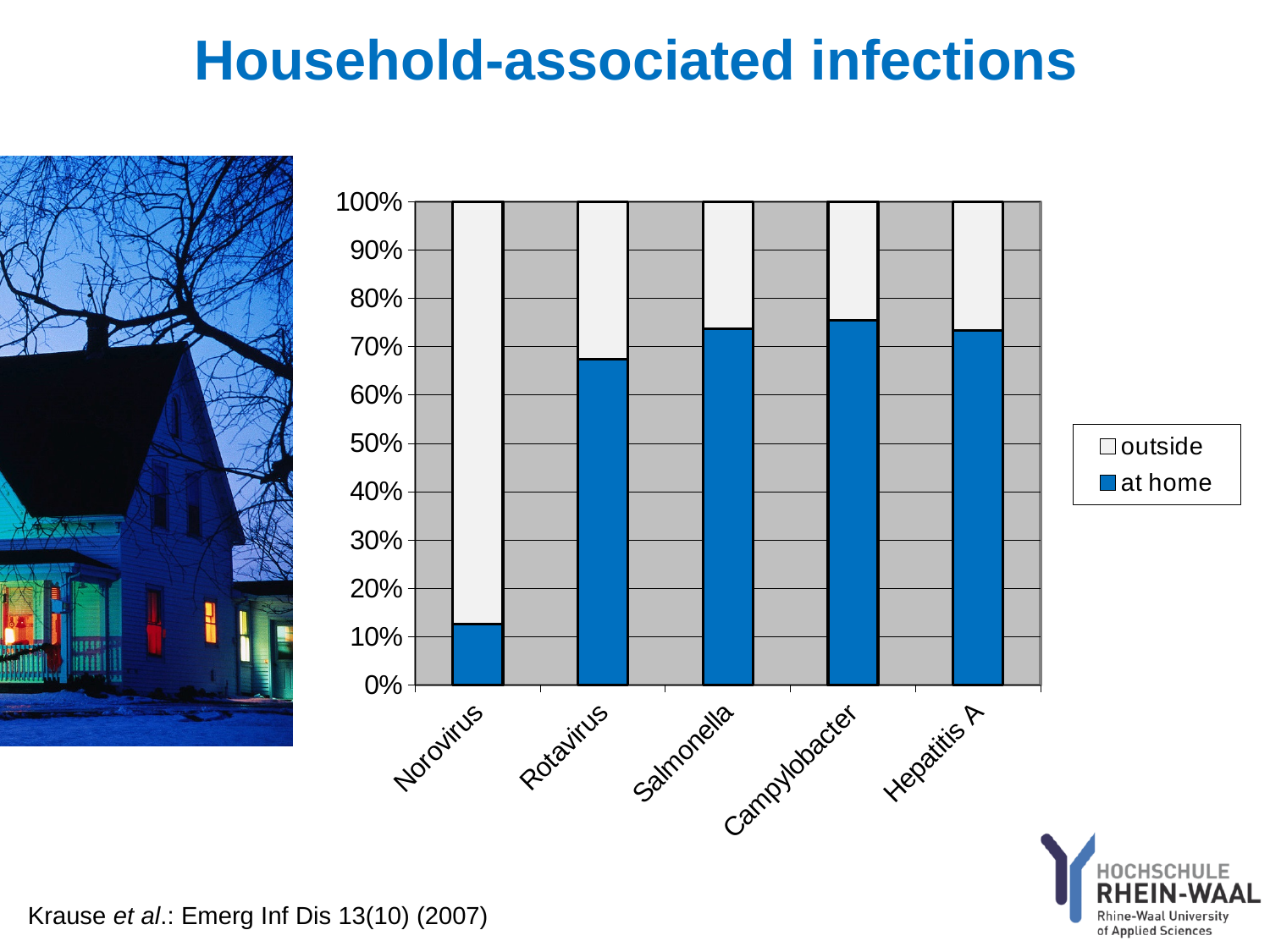
Is the 'at home' value for Campylobacter greater or less than 70%? greater Is the 'at home' value for Hepatitis A greater or less than 80%? less How many infection categories are shown on the x axis of the chart? 5 What is the title of the slide containing the chart? Household-associated infections What is the total height of each stacked bar in the chart? 100% Which series in the chart is shown in blue? at home What kind of chart is shown on the slide? stacked bar chart Which has a larger 'at home' share, Norovirus or Rotavirus? Rotavirus Is the 'at home' value for Norovirus greater or less than 20%? less Which infection has the lowest 'at home' share in the chart? Norovirus How many series does the chart's legend list? 2